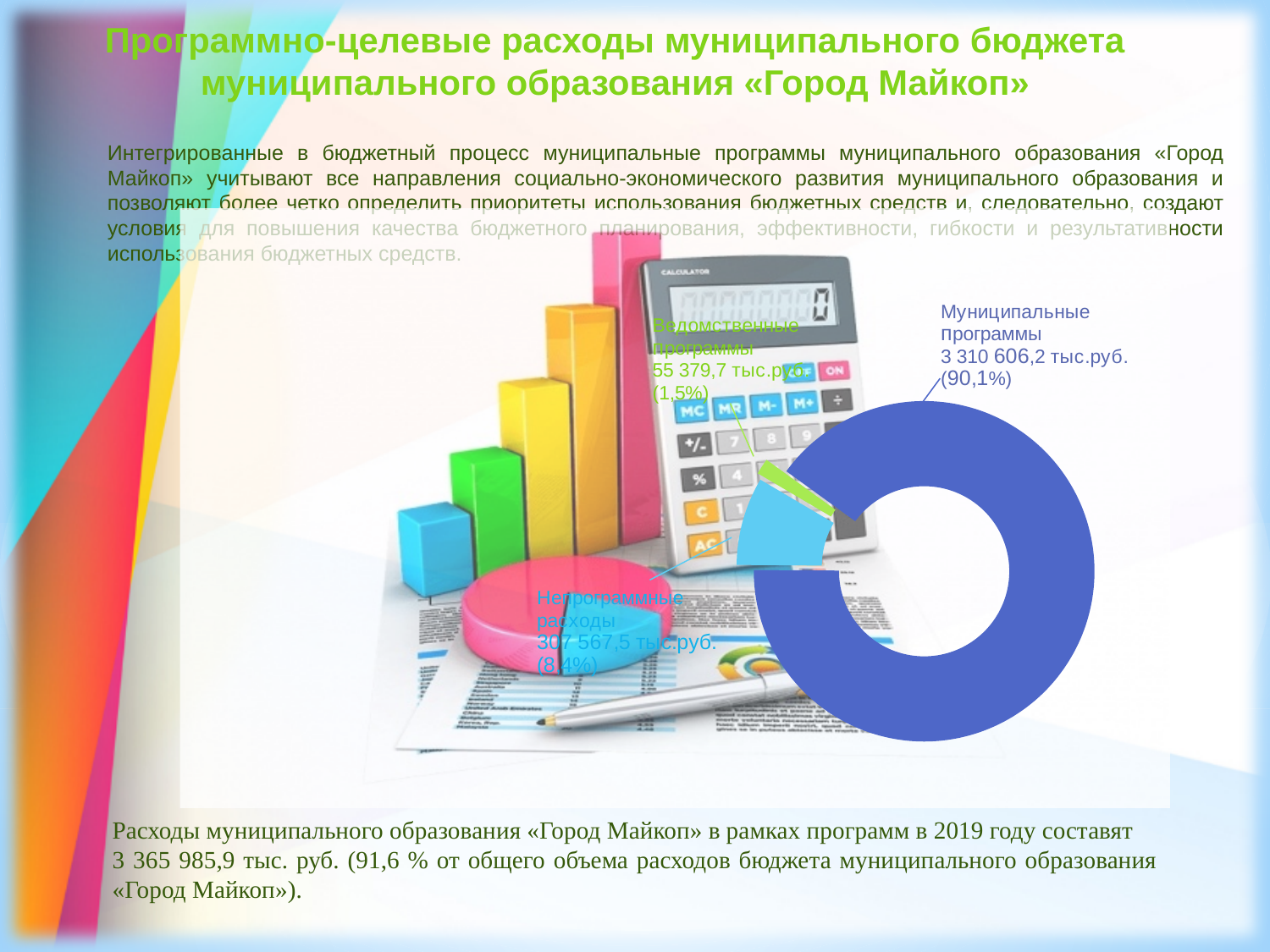
What is the value for Непрограммные расходы? 307 567,5 тыс.руб. What is the value for Муниципальные программы? 3 310 606,2 тыс.руб. What share of the doughnut chart do Муниципальные программы represent? 90,1% Which category has the smallest slice in the doughnut chart? Ведомственные программы What share of the doughnut chart do Ведомственные программы represent? 1,5% What is the value for Ведомственные программы? 55 379,7 тыс.руб. What kind of chart is shown on the slide? doughnut chart What share of the doughnut chart do Непрограммные расходы represent? 8,4% What is the difference in percentage share between Непрограммные расходы and Ведомственные программы? 6,9% Which is larger, Непрограммные расходы or Ведомственные программы? Непрограммные расходы How many slices does the doughnut chart have? 3 Which category has the largest slice in the doughnut chart? Муниципальные программы